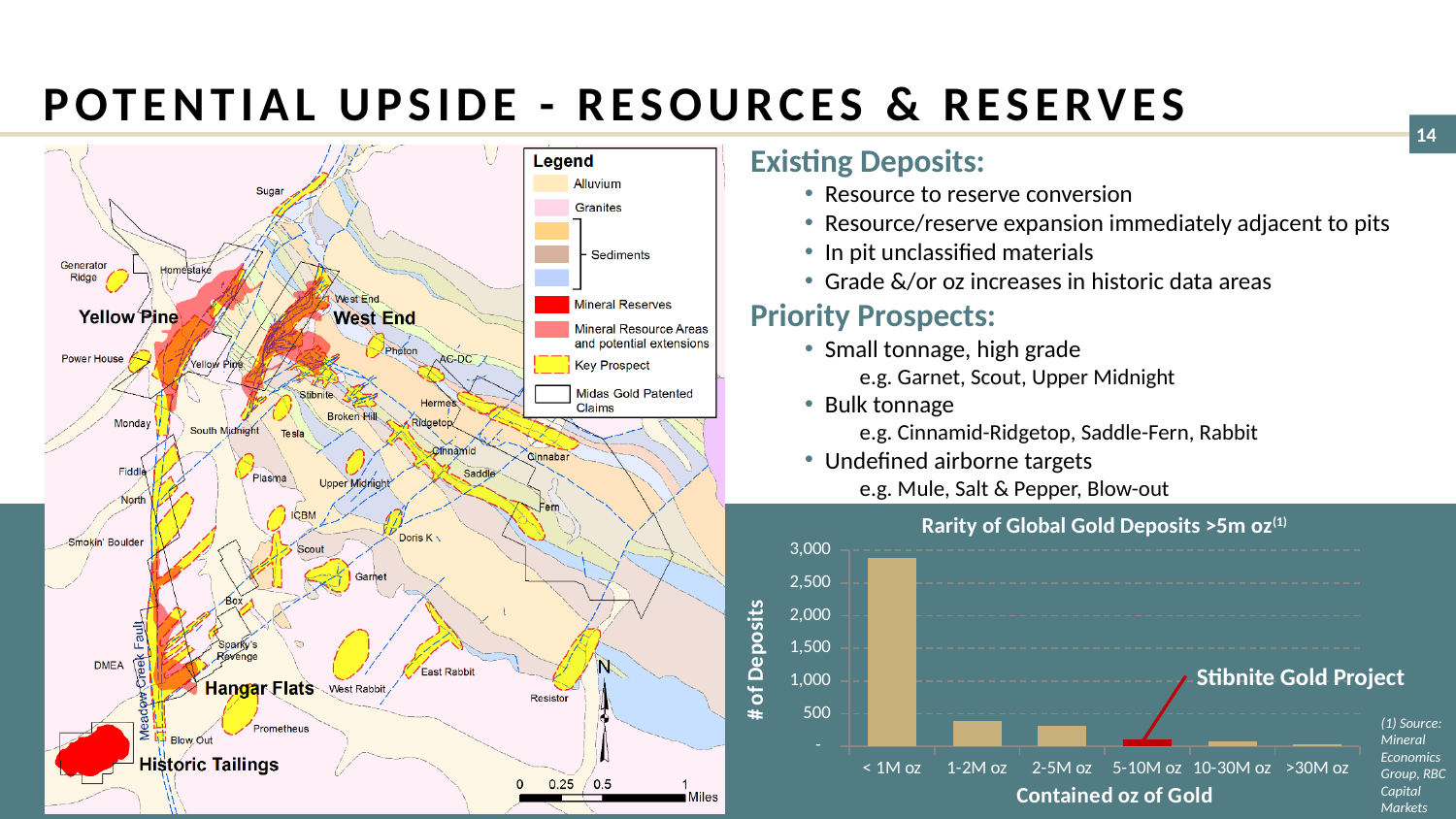
Is the value for 5-10M oz greater or less than 500? less Is the value for < 1M oz greater or less than 2,500? greater Which category has the highest number of deposits in the chart? < 1M oz Which is larger, the number of deposits for < 1M oz or for 1-2M oz? < 1M oz What kind of chart is shown at the bottom right of the slide? bar chart What is the label of the y axis of the chart? # of Deposits Is the value for 2-5M oz greater or less than 500? less How many categories are shown on the x axis of the chart? 6 What is the title of the chart on the slide? Rarity of Global Gold Deposits >5m oz Do the values in the chart rise or fall moving from left to right along the x axis? fall Which category's bar is highlighted in red and labelled Stibnite Gold Project? 5-10M oz